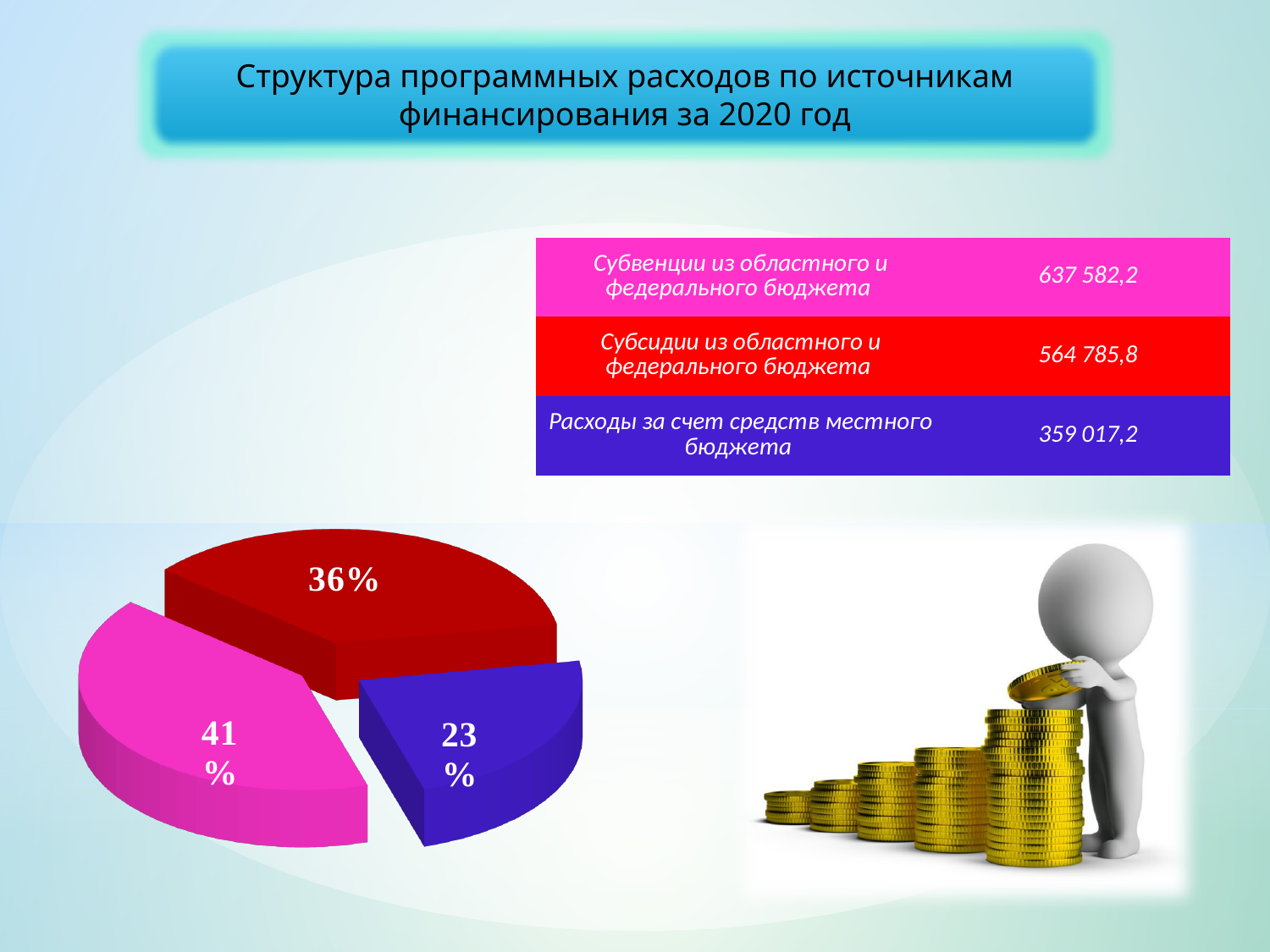
Which is larger: the share for Субсидии из областного и федерального бюджета or the share for Расходы за счет средств местного бюджета? Субсидии из областного и федерального бюджета How many slices does the pie chart have? 3 Which funding source has the largest share of the pie? Субвенции из областного и федерального бюджета What is the difference in percentage points between the pink slice (41%) and the blue slice (23%)? 18 What value is listed for Субвенции из областного и федерального бюджета in the legend table? 637 582,2 What share of the pie does the blue slice (Расходы за счет средств местного бюджета) represent? 23% Which funding source has the smallest share of the pie? Расходы за счет средств местного бюджета What share of the pie does the red slice (Субсидии из областного и федерального бюджета) represent? 36% What share of the pie does the pink slice (Субвенции из областного и федерального бюджета) represent? 41% What value is listed for Расходы за счет средств местного бюджета in the legend table? 359 017,2 What kind of chart is shown on the slide? pie chart What colour is the slice for Субсидии из областного и федерального бюджета? red